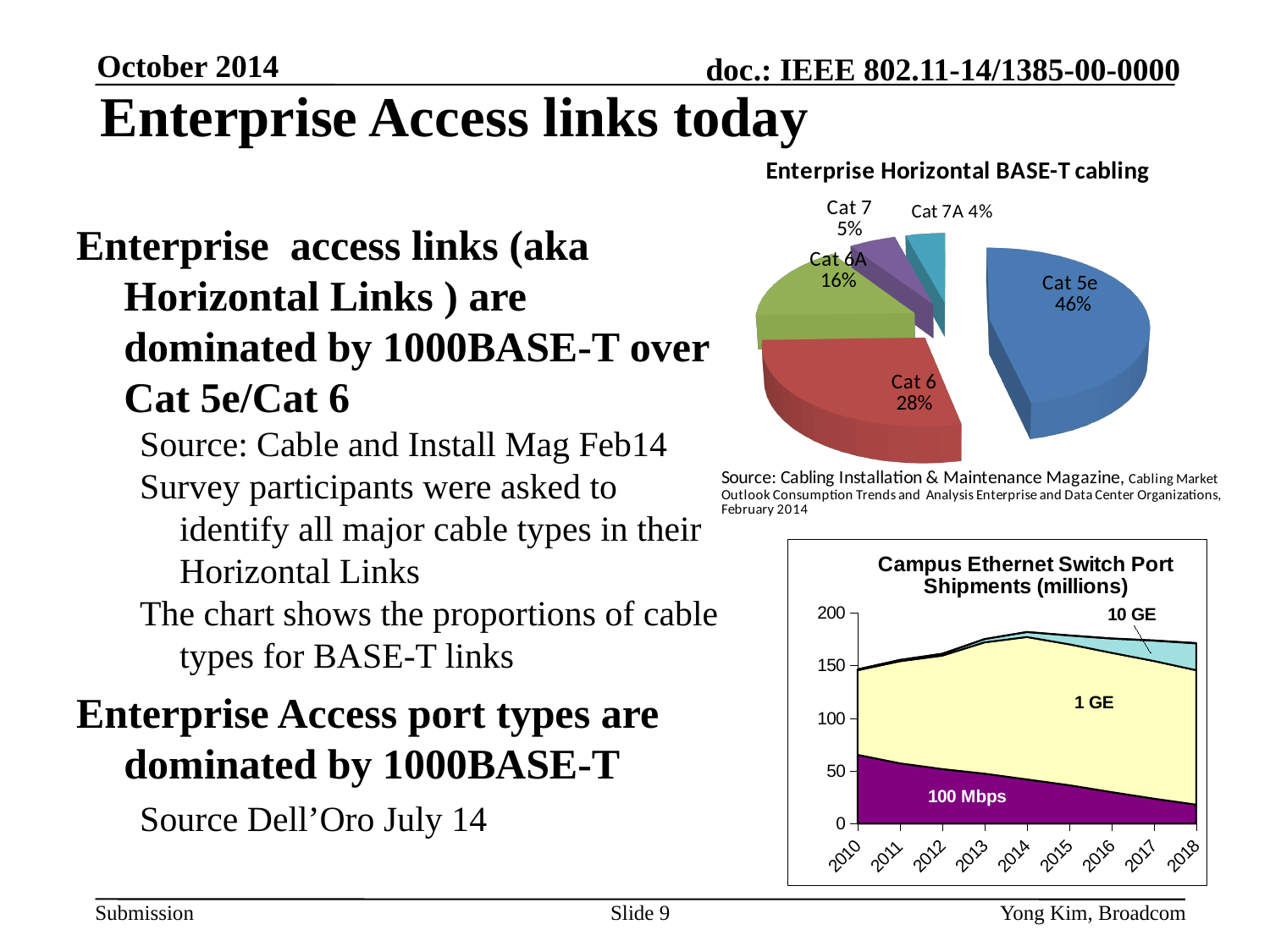
How many cable types are shown in the Enterprise Horizontal BASE-T cabling chart? 5 What kind of chart is the Enterprise Horizontal BASE-T cabling chart? Pie chart In the Enterprise Horizontal BASE-T cabling chart, which cable type has the largest share? Cat 5e In the Campus Ethernet Switch Port Shipments chart, do the 100 Mbps shipments rise or fall from 2010 to 2018? Fall In the Campus Ethernet Switch Port Shipments chart, is the total shipment value for 2010 greater or less than 100? greater In the Enterprise Horizontal BASE-T cabling chart, what share does Cat 6A have? 16% In the Enterprise Horizontal BASE-T cabling chart, how many percentage points larger is Cat 5e's share than Cat 6's? 18 What kind of chart is the Campus Ethernet Switch Port Shipments chart? Stacked area chart In the Enterprise Horizontal BASE-T cabling chart, which has the larger share, Cat 6A or Cat 7? Cat 6A In the Enterprise Horizontal BASE-T cabling chart, what share does Cat 5e have? 46% In the Enterprise Horizontal BASE-T cabling chart, which cable type has the smallest share? Cat 7A How many series are shown in the Campus Ethernet Switch Port Shipments chart? 3